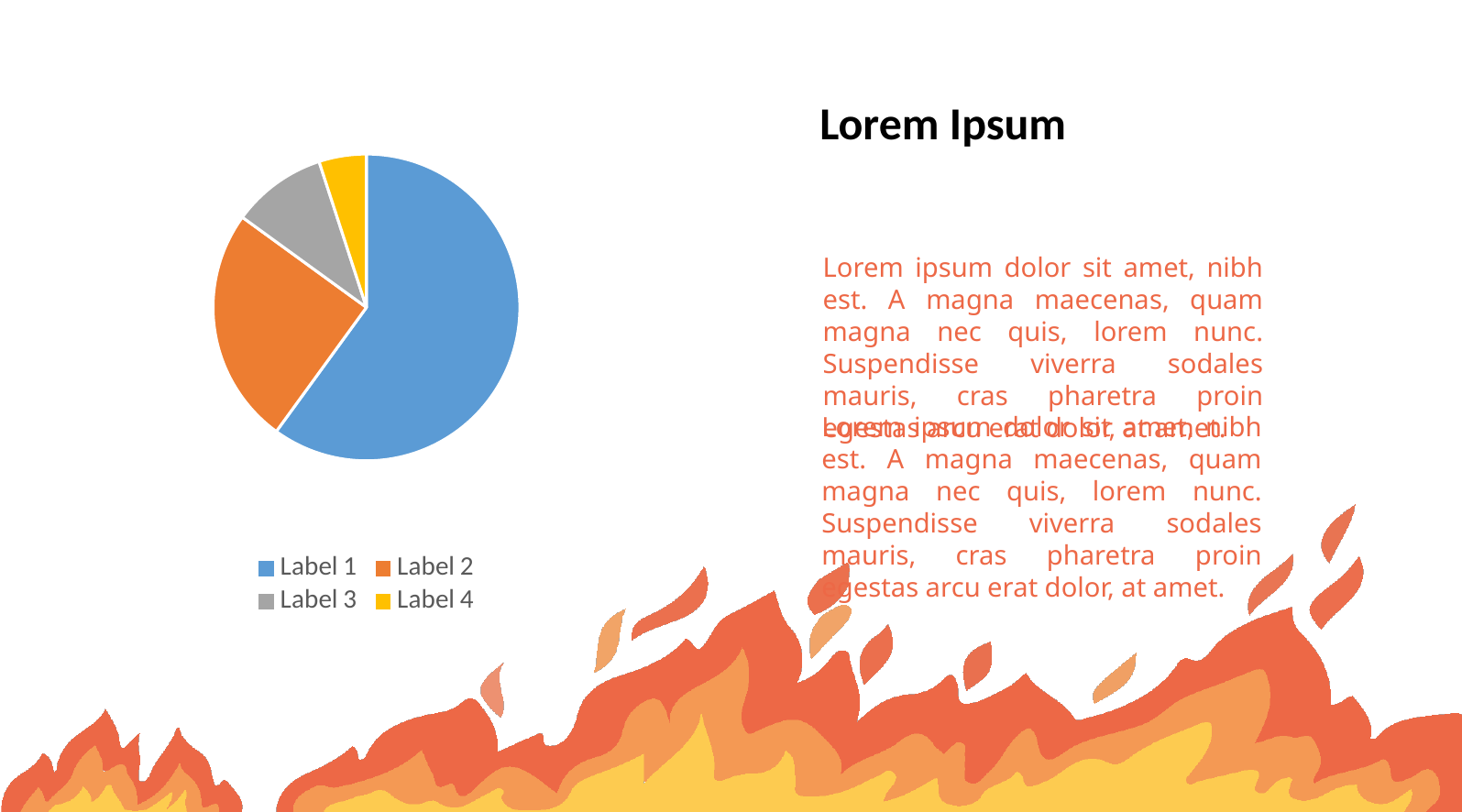
How many entries does the legend of the pie chart list? 4 Which slice is smaller in the pie chart, Label 1 or Label 4? Label 4 Which legend entry is shown in yellow in the pie chart? Label 4 What colour is the Label 1 slice in the pie chart? blue Which slice is larger in the pie chart, Label 1 or Label 2? Label 1 Which category has the smallest slice in the pie chart? Label 4 Which category has the largest slice in the pie chart? Label 1 What kind of chart is shown on the slide? pie chart Which slice is larger in the pie chart, Label 3 or Label 4? Label 3 How many slices does the pie chart have? 4